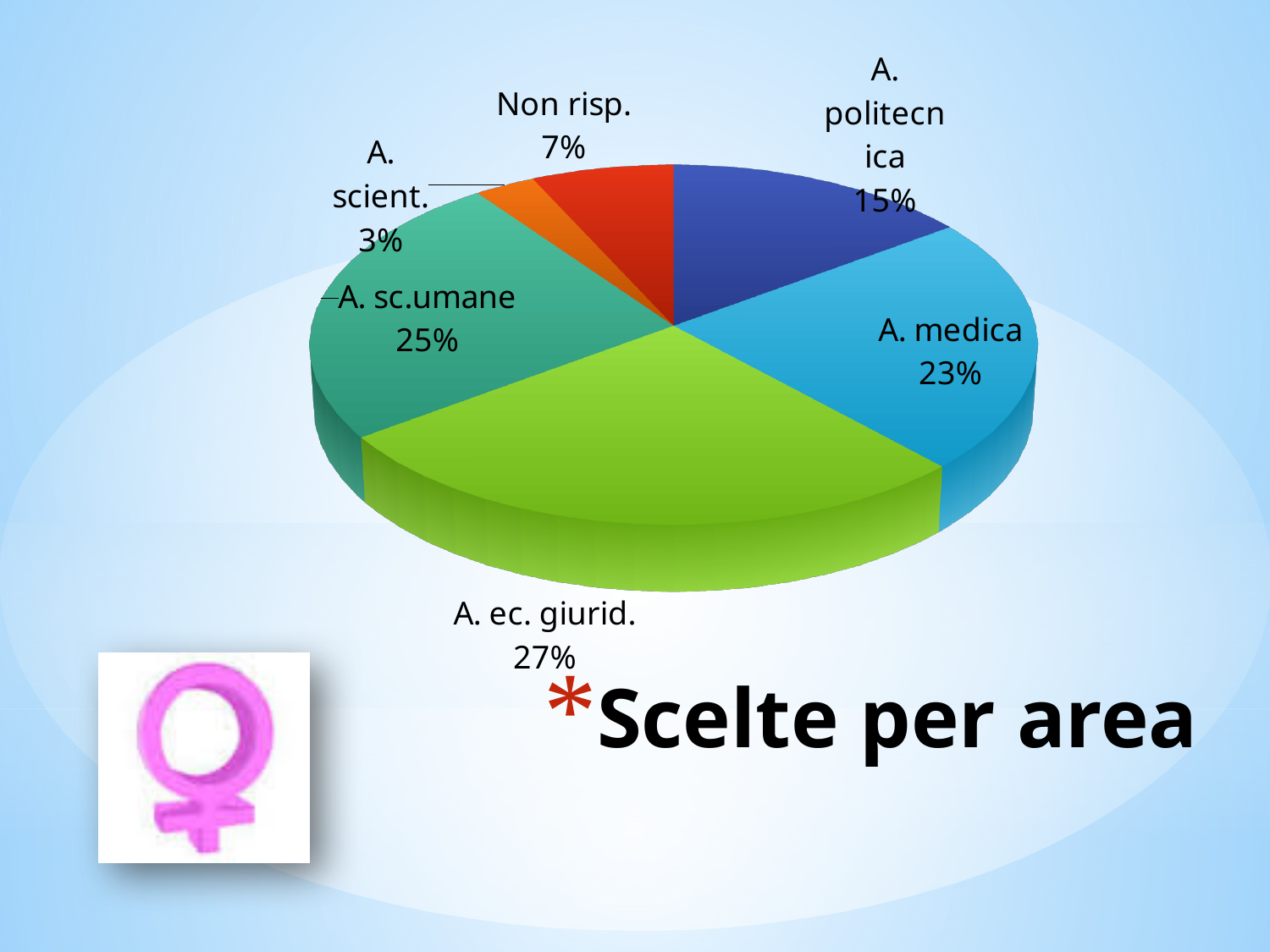
What is the difference in percentage points between A. ec. giurid. and A. politecnica? 12 What is the title shown on the slide for the chart? Scelte per area What is the difference in percentage points between Non risp. and A. scient.? 4 How many slices does the pie chart have? 6 What share of the pie does Non risp. have? 7% What share of the pie does A. medica have? 23% What share of the pie does A. politecnica have? 15% Which slice of the pie is the smallest? A. scient. Which slice of the pie is the largest? A. ec. giurid. Which is larger, the share for A. sc.umane or the share for A. medica? A. sc.umane What kind of chart is shown on the slide? pie chart